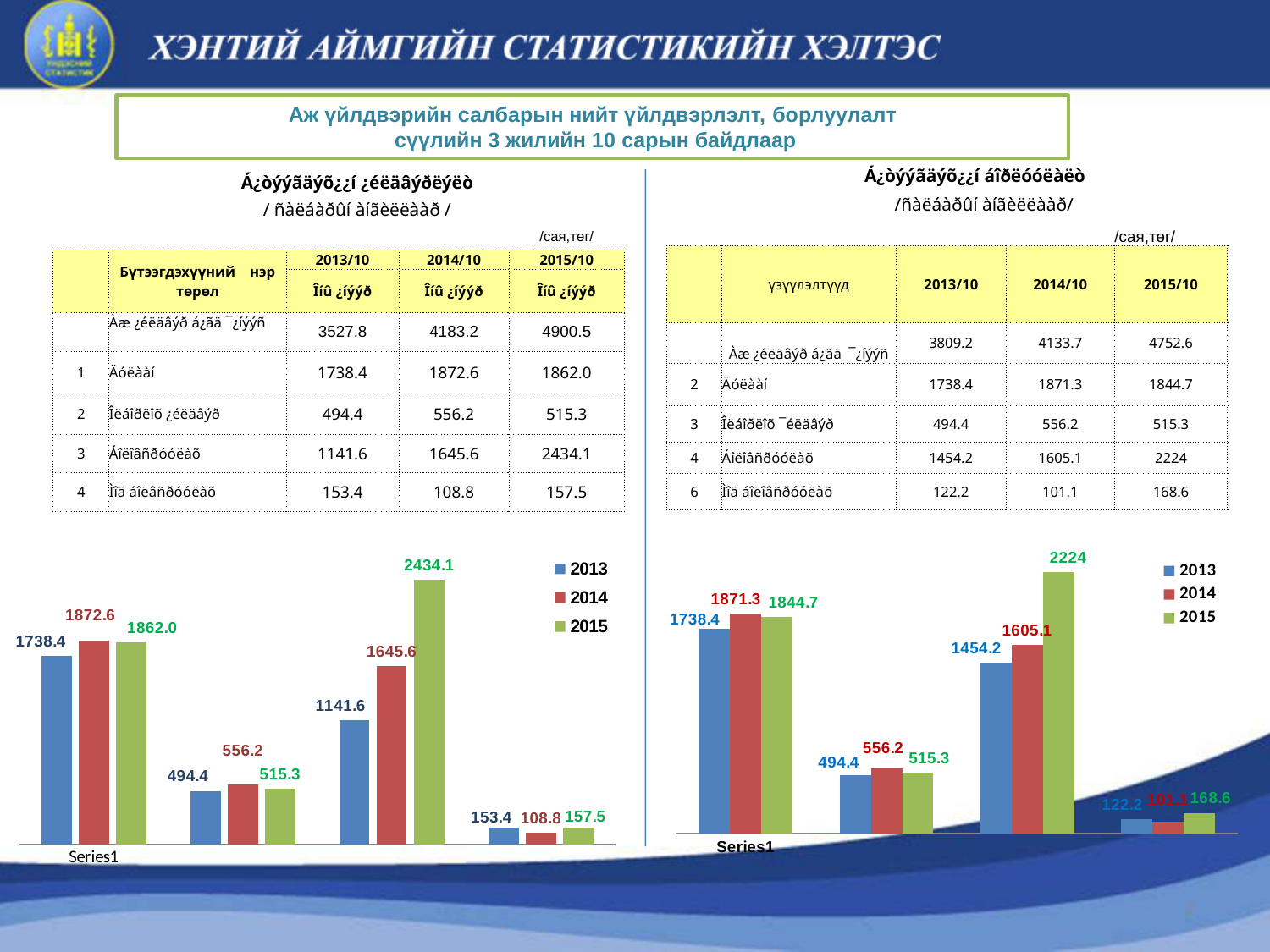
How many groups of bars are shown on the right chart? 4 On the right chart, what is the value of the 2014 bar in the fourth group of bars? 101.1 What type of chart is shown on the left side of the slide? Bar chart How many series does the legend of the left chart list? 3 On the right chart, what is the value of the 2015 bar in the third group of bars from the left? 2224 On the left chart, which bar has the lowest value? 2014 bar in the fourth group (108.8) On the left chart, what is the value of the 2015 bar in the third group of bars from the left? 2434.1 On the right chart, what is the difference between the 2014 and 2013 bars in the first group of bars? 132.9 On the left chart, which bar has the highest value? 2015 bar in the third group (2434.1) On the left chart, what is the value of the 2013 bar in the first group of bars? 1738.4 On the right chart, which is larger in the first group of bars: the 2014 bar or the 2015 bar? 2014 bar On the left chart, what is the difference between the 2015 and 2013 bars in the third group of bars? 1292.5